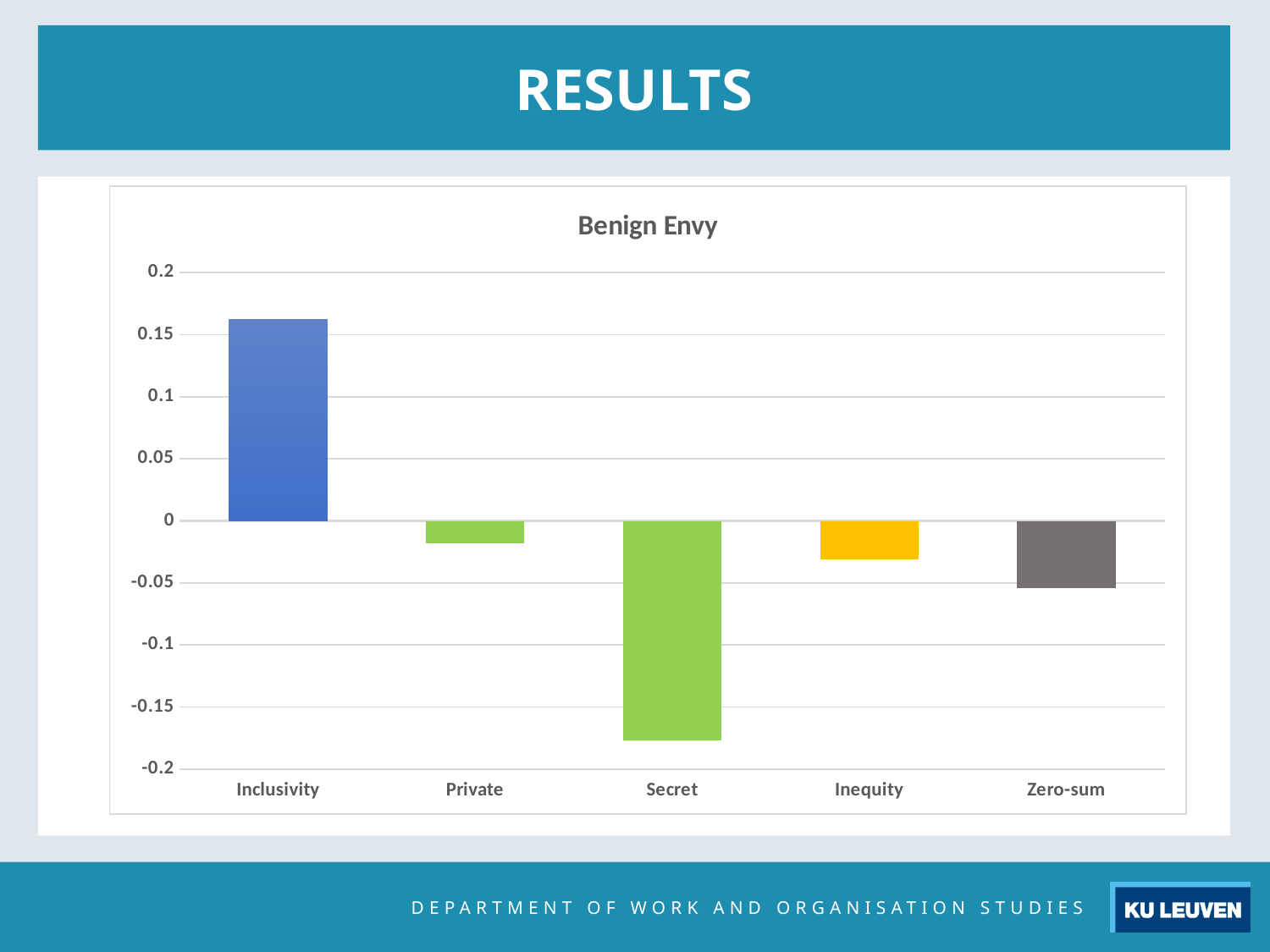
Is the value for Inequity greater or less than -0.05? greater Is the value for Secret greater or less than -0.15? less Which has the larger value, Private or Zero-sum? Private How many categories are shown on the x axis of the chart? 5 What kind of chart is shown on the slide? Bar chart What is the title of the chart? Benign Envy Which has the larger value, Inequity or Zero-sum? Inequity Is the value for Inclusivity greater or less than 0.1? greater Which category has the lowest value in the Benign Envy chart? Secret Which category has the highest value in the Benign Envy chart? Inclusivity How many categories in the chart have a positive value? 1